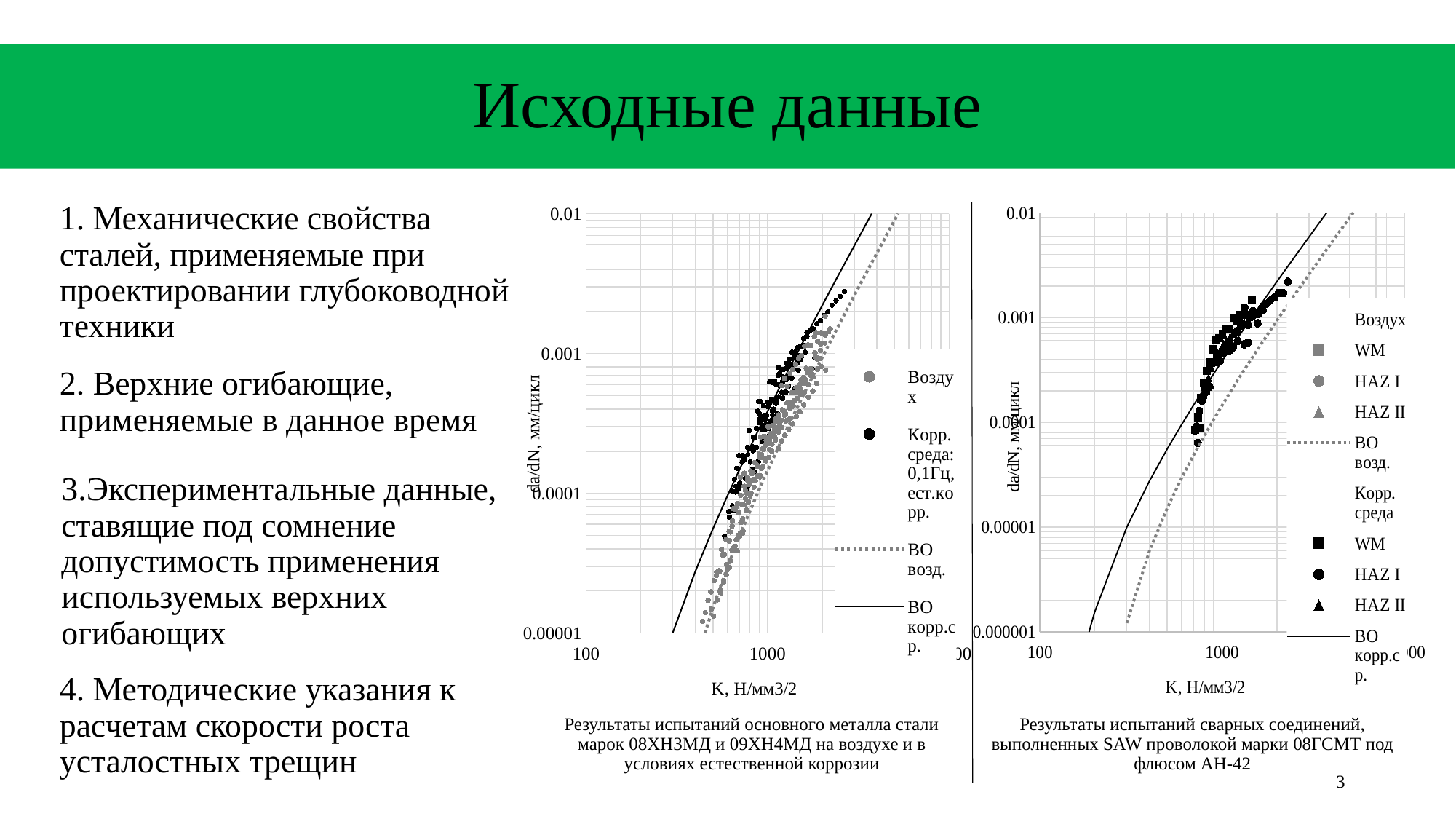
In the left chart, are the da/dN values of the Воздух series at K = 1000 greater or less than 0.001? less What kind of chart is the right chart on the slide? scatter chart In the left chart, which series lies higher on the plot at the same K: Воздух or Корр. среда? Корр. среда In the left chart, how many entries does the legend list? 4 In the right chart, do the plotted da/dN values rise or fall as K increases? rise What is the x-axis label of the left chart? K, Н/мм3/2 What kind of chart is the left chart on the slide? scatter chart In the left chart, which line lies higher: ВО возд. or ВО корр.ср.? ВО корр.ср. What is the y-axis label of the right chart? da/dN, мм/цикл In the left chart, do the da/dN values rise or fall as K increases along the x axis? rise